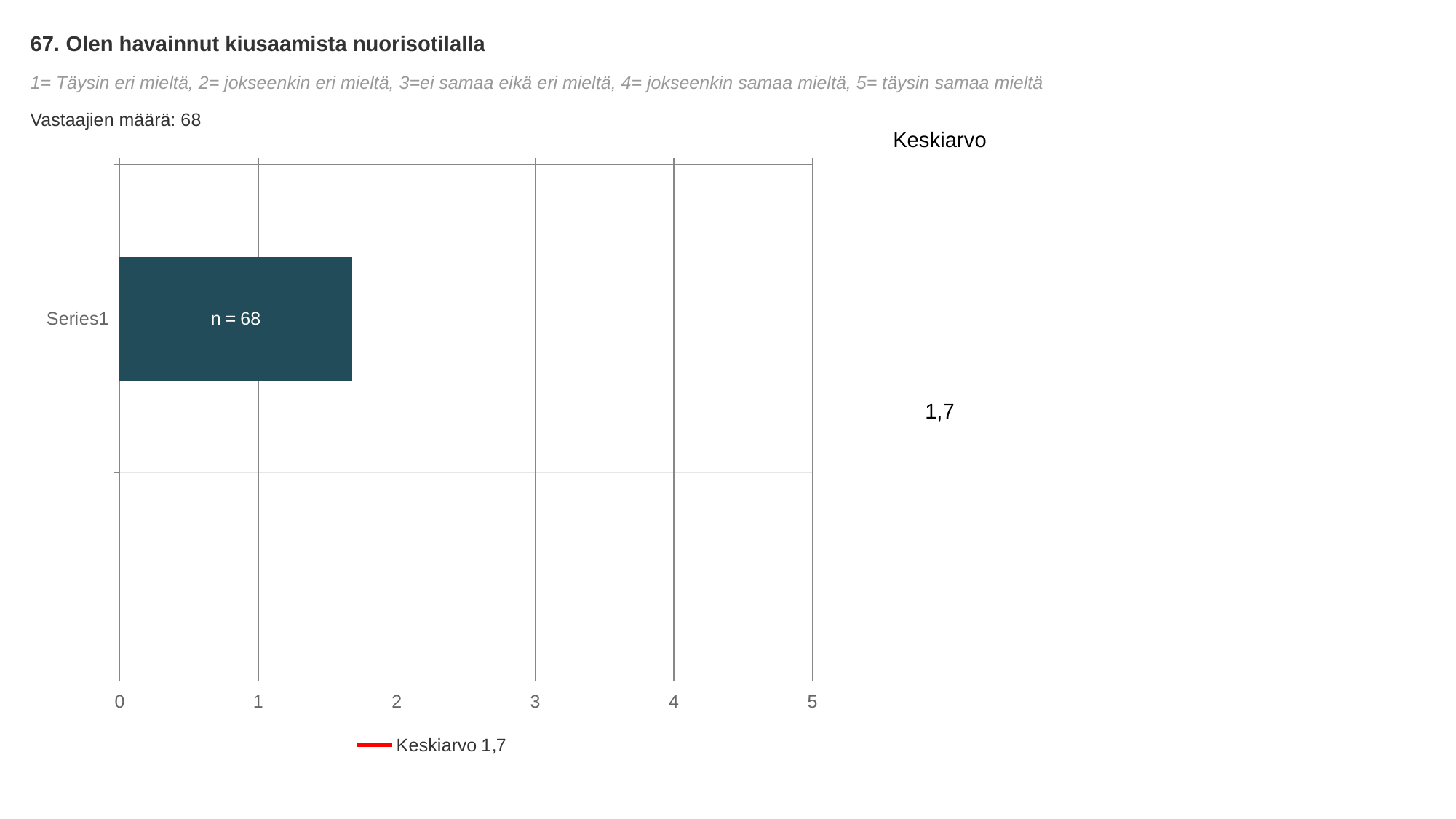
What kind of chart is shown on the slide? bar chart Is the value of the Series1 bar greater or less than 2? less How many bars are plotted in the chart? 1 Is the value of the Series1 bar greater or less than 1? greater What is the highest value shown on the horizontal axis? 5 What is the label printed inside the Series1 bar? n = 68 How many respondents (Vastaajien määrä) are reported on the slide? 68 What is the Keskiarvo (mean) value shown for the chart? 1,7 What is the title of the chart on the slide? 67. Olen havainnut kiusaamista nuorisotilalla What is the category label of the single bar in the chart? Series1